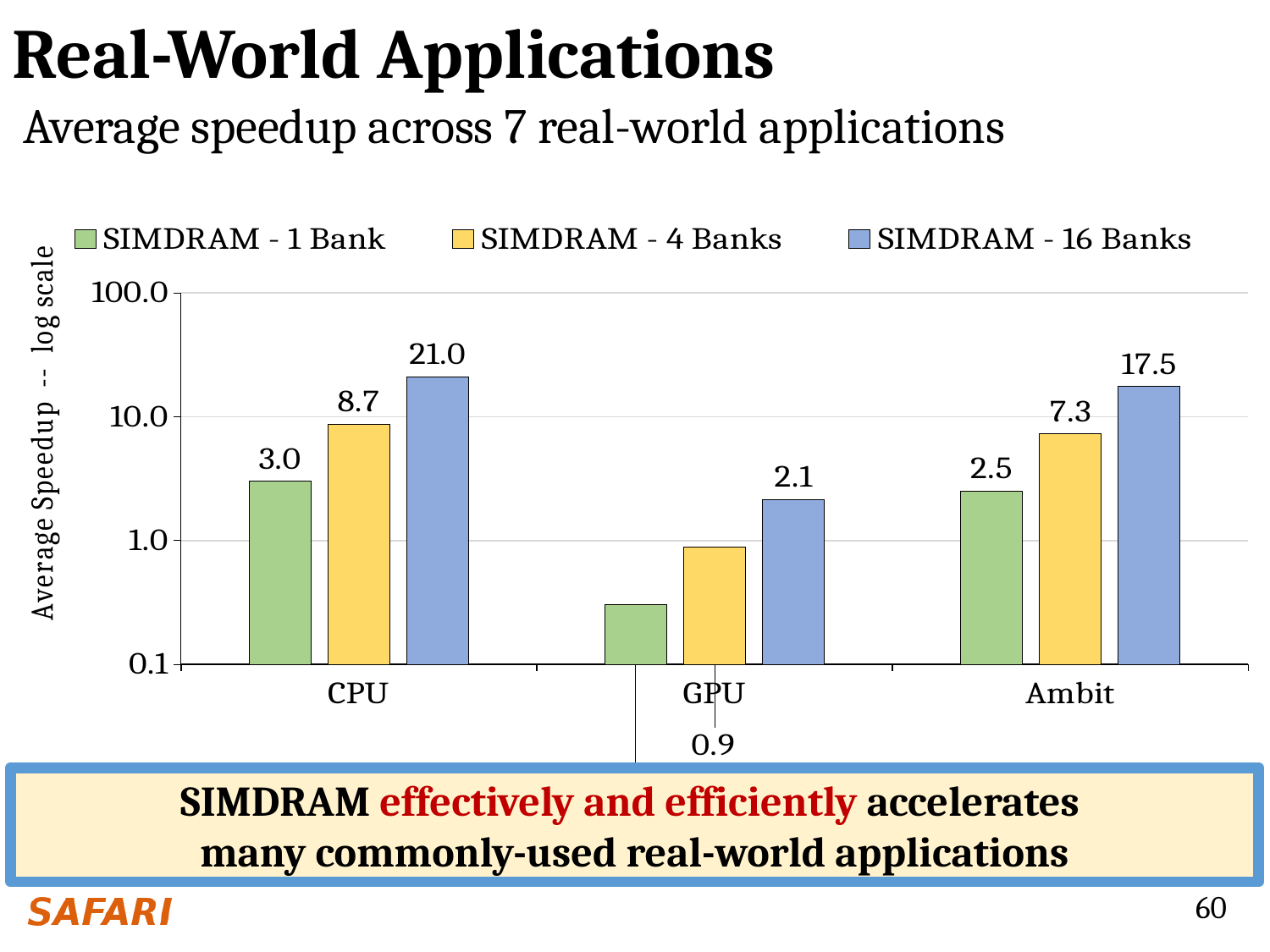
Which category has the lowest SIMDRAM - 4 Banks speedup? GPU Which category has the highest SIMDRAM - 16 Banks speedup? CPU What is the difference between the SIMDRAM - 16 Banks speedup for CPU and for Ambit? 3.5 Which is larger: the SIMDRAM - 4 Banks speedup for CPU or the SIMDRAM - 16 Banks speedup for Ambit? SIMDRAM - 16 Banks speedup for Ambit How many series does the legend list? 3 What is the average speedup of SIMDRAM - 4 Banks for Ambit? 7.3 Is the SIMDRAM - 1 Bank speedup for GPU greater or less than 1.0? less What is the average speedup of SIMDRAM - 1 Bank for CPU? 3.0 What is the average speedup of SIMDRAM - 4 Banks for GPU? 0.9 What is the average speedup of SIMDRAM - 16 Banks for CPU? 21.0 How many categories are shown on the x axis? 3 What kind of chart is shown on the slide? bar chart